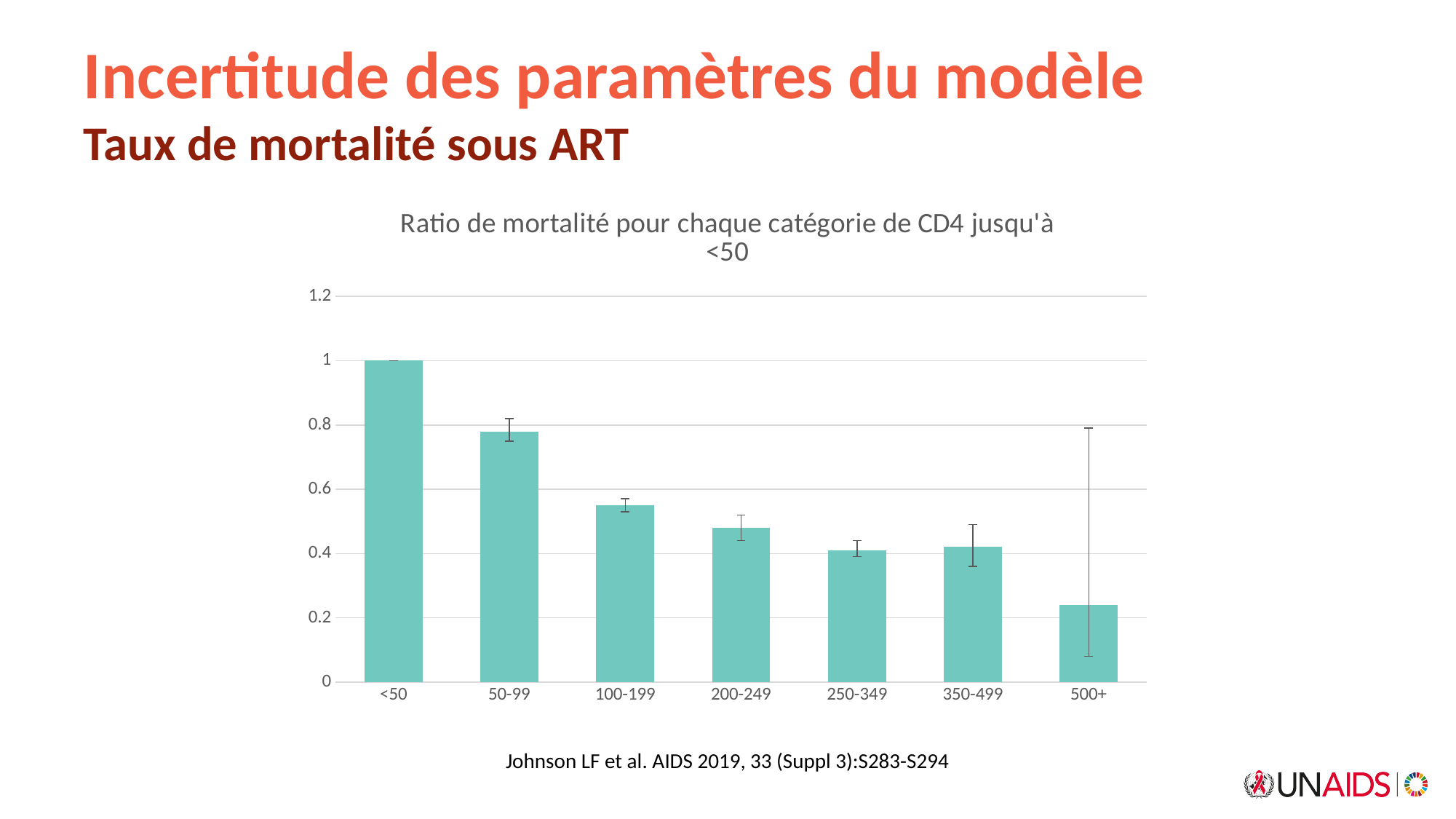
What is the mortality ratio for the <50 CD4 category? 1 Do the mortality ratios generally rise or fall as the CD4 category increases along the x axis? fall Is the value for 100-199 greater or less than 0.4? greater How many CD4 categories are shown on the x axis? 7 What is the title of the chart? Ratio de mortalité pour chaque catégorie de CD4 jusqu'à <50 Is the value for 50-99 greater or less than 0.6? greater Which has a higher mortality ratio, 50-99 or 100-199? 50-99 Which CD4 category has the lowest mortality ratio? 500+ Is the value for 500+ greater or less than 0.4? less Which CD4 category has the highest mortality ratio? <50 What kind of chart is shown on the slide? bar chart